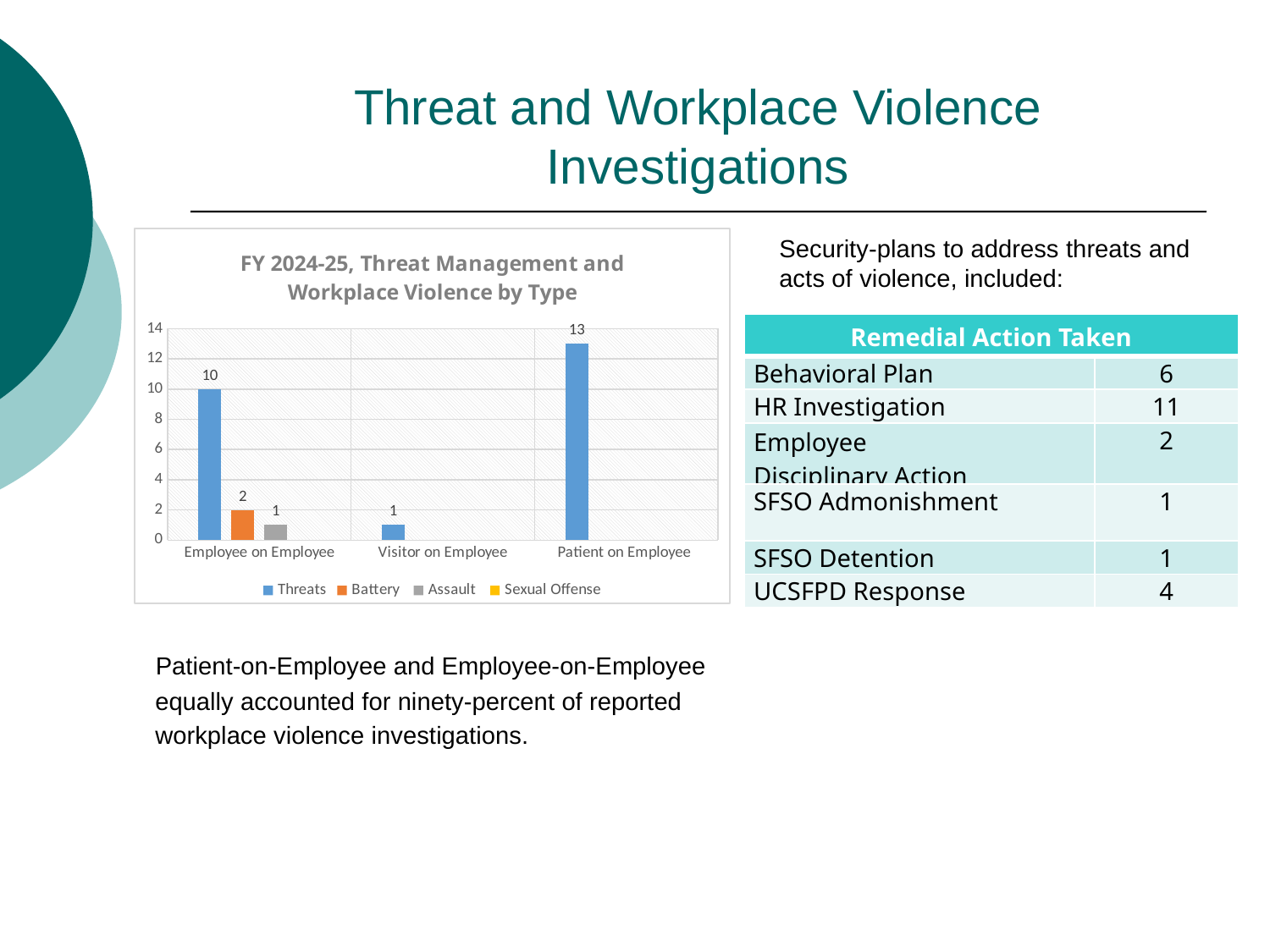
How many series does the legend list? 4 What is the difference between the Threats values for Patient on Employee and Employee on Employee? 3 What is the value for Threats in the Patient on Employee category? 13 What kind of chart is shown? Bar chart How many categories are shown on the x axis? 3 What is the value for Battery in the Employee on Employee category? 2 Which category has the lowest Threats value? Visitor on Employee Which is larger, the Threats value for Employee on Employee or for Visitor on Employee? Employee on Employee What is the value for Threats in the Visitor on Employee category? 1 What is the value for Threats in the Employee on Employee category? 10 Which category has the highest Threats value? Patient on Employee What is the value for Assault in the Employee on Employee category? 1